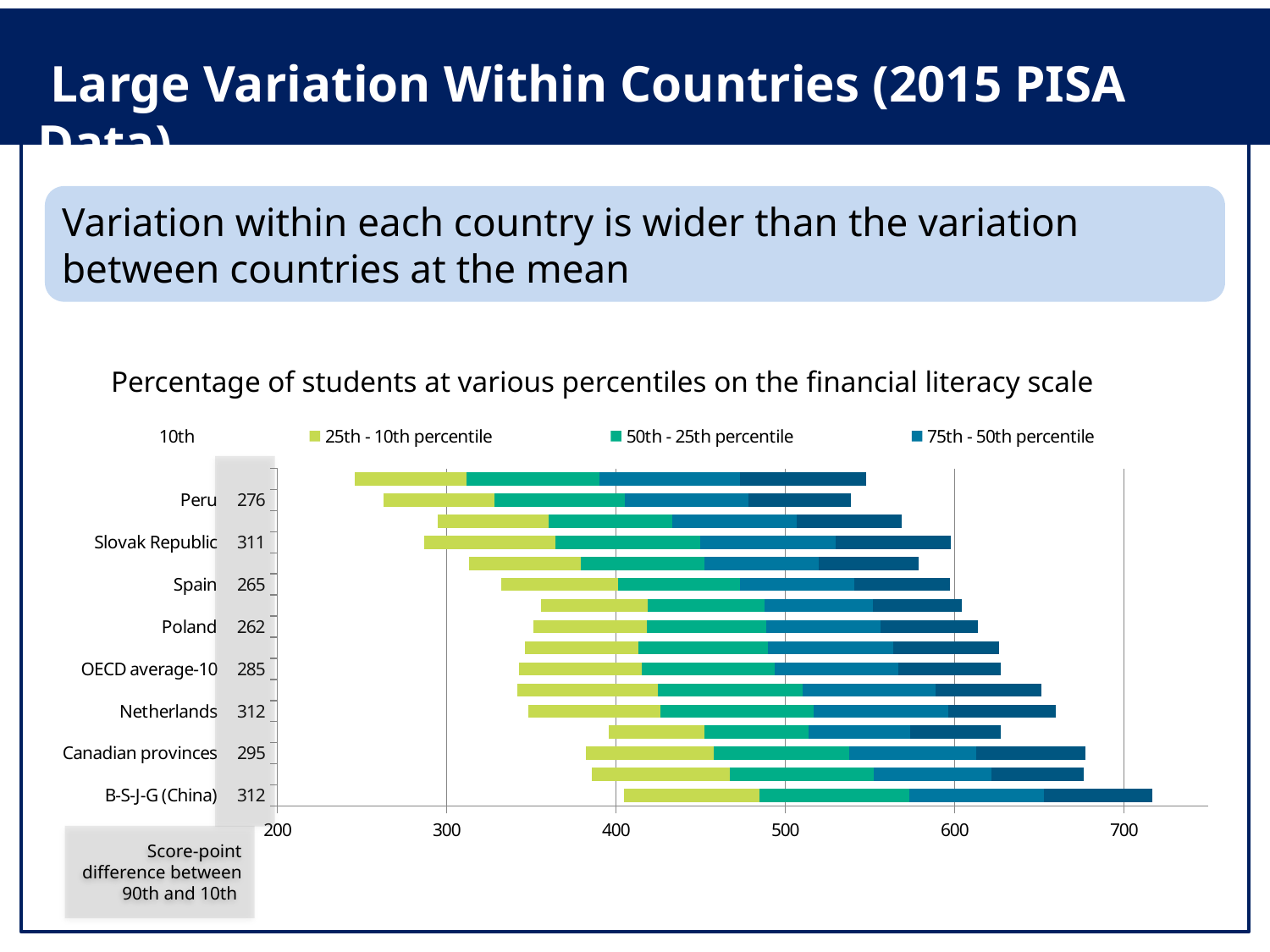
What is the score-point difference between the 90th and 10th percentiles for Spain? 265 Is the right end of the bar for B-S-J-G (China) greater or less than 700? greater What kind of chart is shown on the slide? Bar chart Among the labeled countries, which has the lowest score-point difference between the 90th and 10th percentiles? Poland What is the score-point difference between the 90th and 10th percentiles for the OECD average-10? 285 What is the score-point difference between the 90th and 10th percentiles for Peru? 276 How many countries or regions are labeled on the vertical axis of the chart? 8 What is the score-point difference between the 90th and 10th percentiles for the Canadian provinces? 295 What is the title of the chart? Percentage of students at various percentiles on the financial literacy scale What is the score-point difference between the 90th and 10th percentiles for the Slovak Republic? 311 How much larger is the Slovak Republic's score-point difference (90th minus 10th) than Spain's? 46 Which has a larger score-point difference between the 90th and 10th percentiles, Peru or Spain? Peru